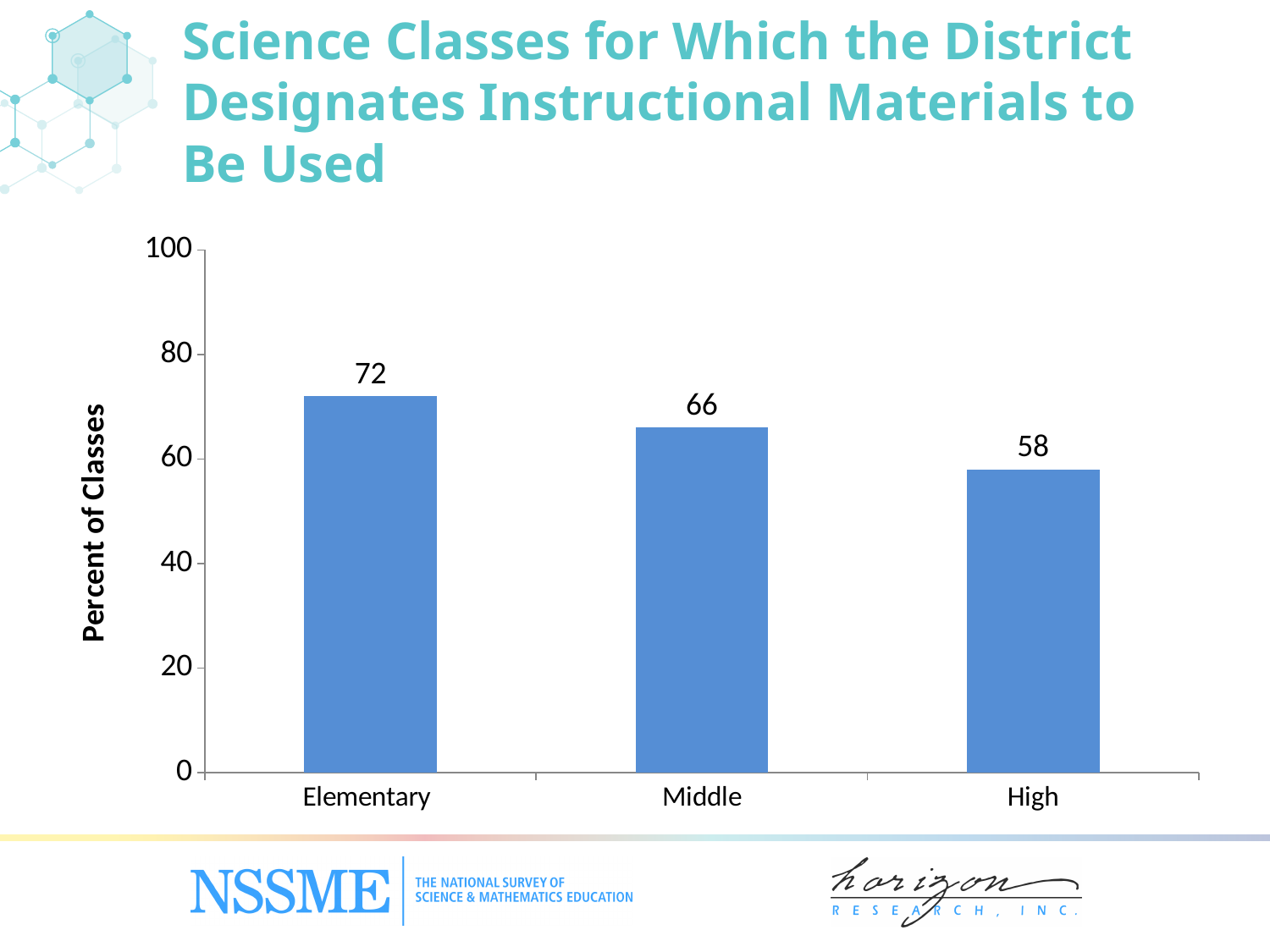
What is the label of the y axis? Percent of Classes What is the value for Middle? 66 Which category has the lowest value? High What is the difference between the values for Elementary and High? 14 Is the value for High greater or less than 60? less Which category has the highest value? Elementary What is the value for Elementary? 72 What kind of chart is shown on the slide? bar chart What is the value for High? 58 What is the difference between the values for Middle and High? 8 Which is larger, the value for Elementary or the value for Middle? Elementary How many categories are shown on the x axis? 3